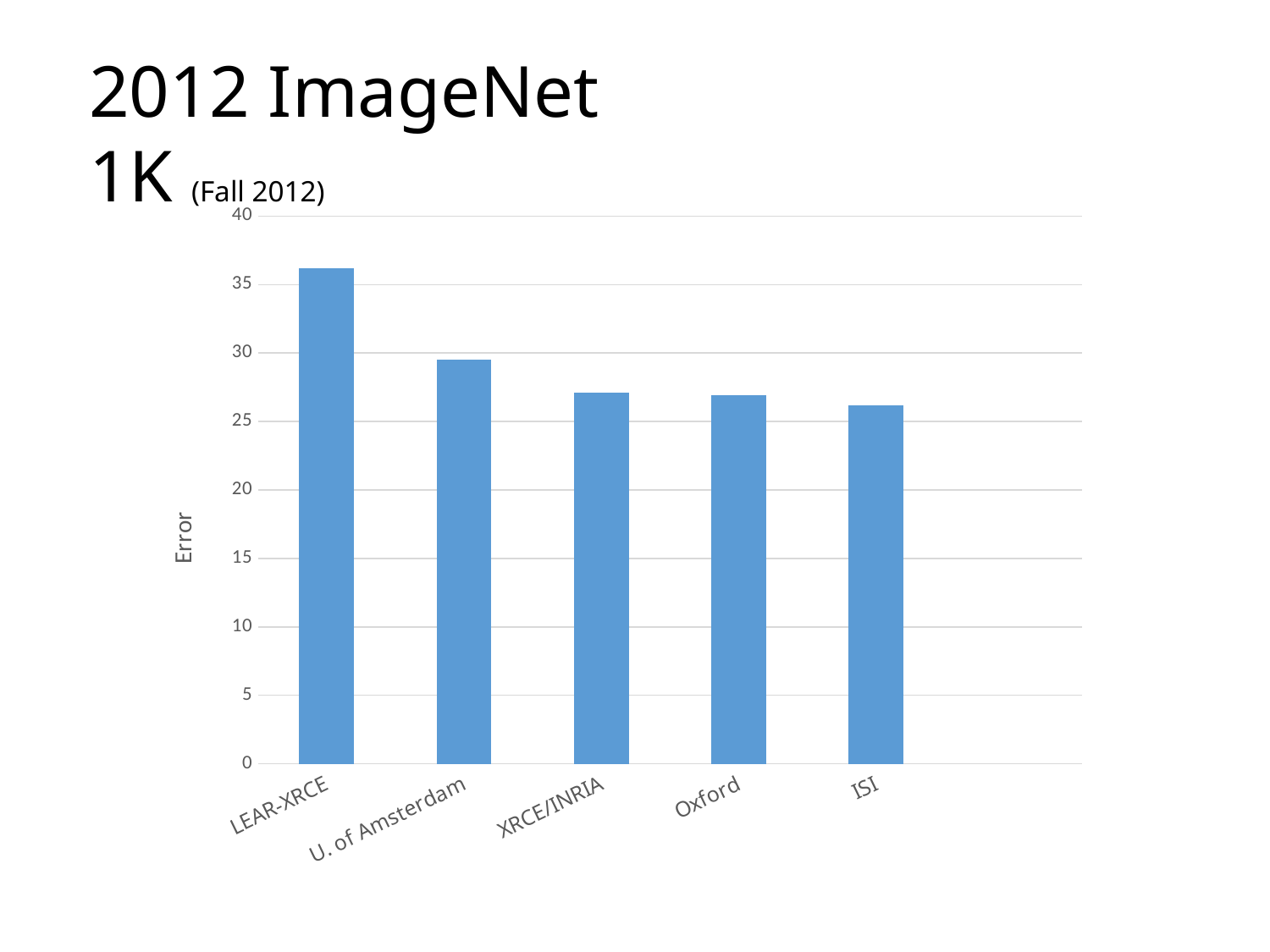
Is the error for XRCE/INRIA greater or less than 30? less Is the error for LEAR-XRCE greater or less than 30? greater Is the error for U. of Amsterdam greater or less than 25? greater Which has a higher error, U. of Amsterdam or ISI? U. of Amsterdam What is the label on the vertical axis of the chart? Error What kind of chart is shown on the slide? bar chart Do the error values rise or fall moving from left to right along the x axis? fall Which team has the highest error in the chart? LEAR-XRCE Which has a higher error, LEAR-XRCE or U. of Amsterdam? LEAR-XRCE How many teams (categories) are shown on the x axis of the chart? 5